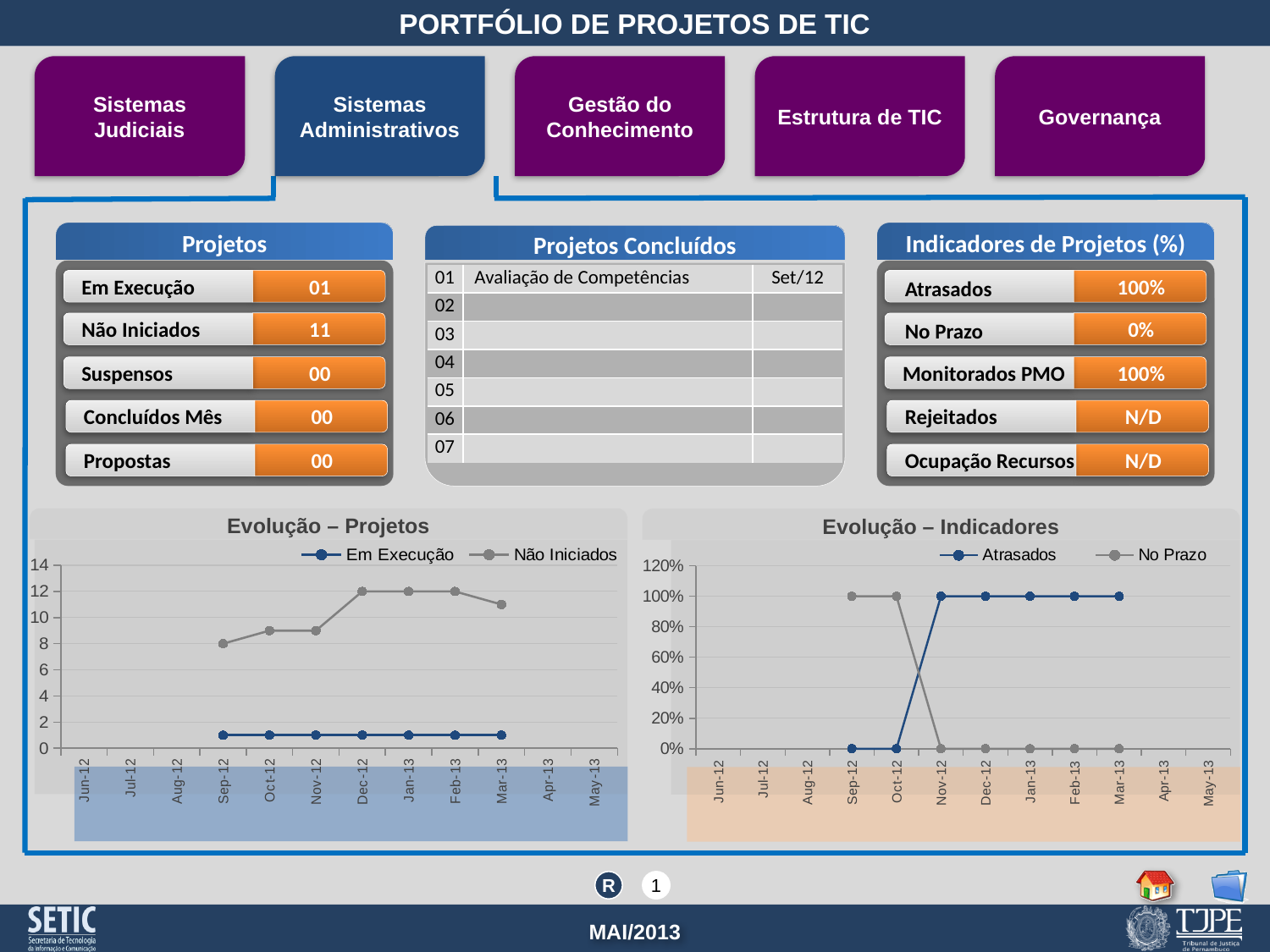
In the 'Evolução – Projetos' chart, what is the value of Não Iniciados in Dec-12? 12 In the 'Evolução – Indicadores' chart, how many months have plotted data points for the Atrasados series? 7 In the 'Evolução – Projetos' chart, which series has the higher value in Feb-13, Em Execução or Não Iniciados? Não Iniciados In the 'Evolução – Indicadores' chart, what is the difference between Atrasados and No Prazo in Dec-12? 100% How many series does the legend of the 'Evolução – Indicadores' chart list? 2 In the 'Evolução – Projetos' chart, is the value of Em Execução in Jan-13 greater or less than 2? less In the 'Evolução – Projetos' chart, in which month does Não Iniciados reach its lowest value? Sep-12 In the 'Evolução – Indicadores' chart, what is the value of No Prazo in Sep-12? 100% What kind of chart is the 'Evolução – Projetos' chart? line chart In the 'Evolução – Indicadores' chart, does the No Prazo series rise or fall between Oct-12 and Nov-12? fall In the 'Evolução – Projetos' chart, what is the value of Não Iniciados in Sep-12? 8 In the 'Evolução – Indicadores' chart, what is the value of Atrasados in Mar-13? 100%